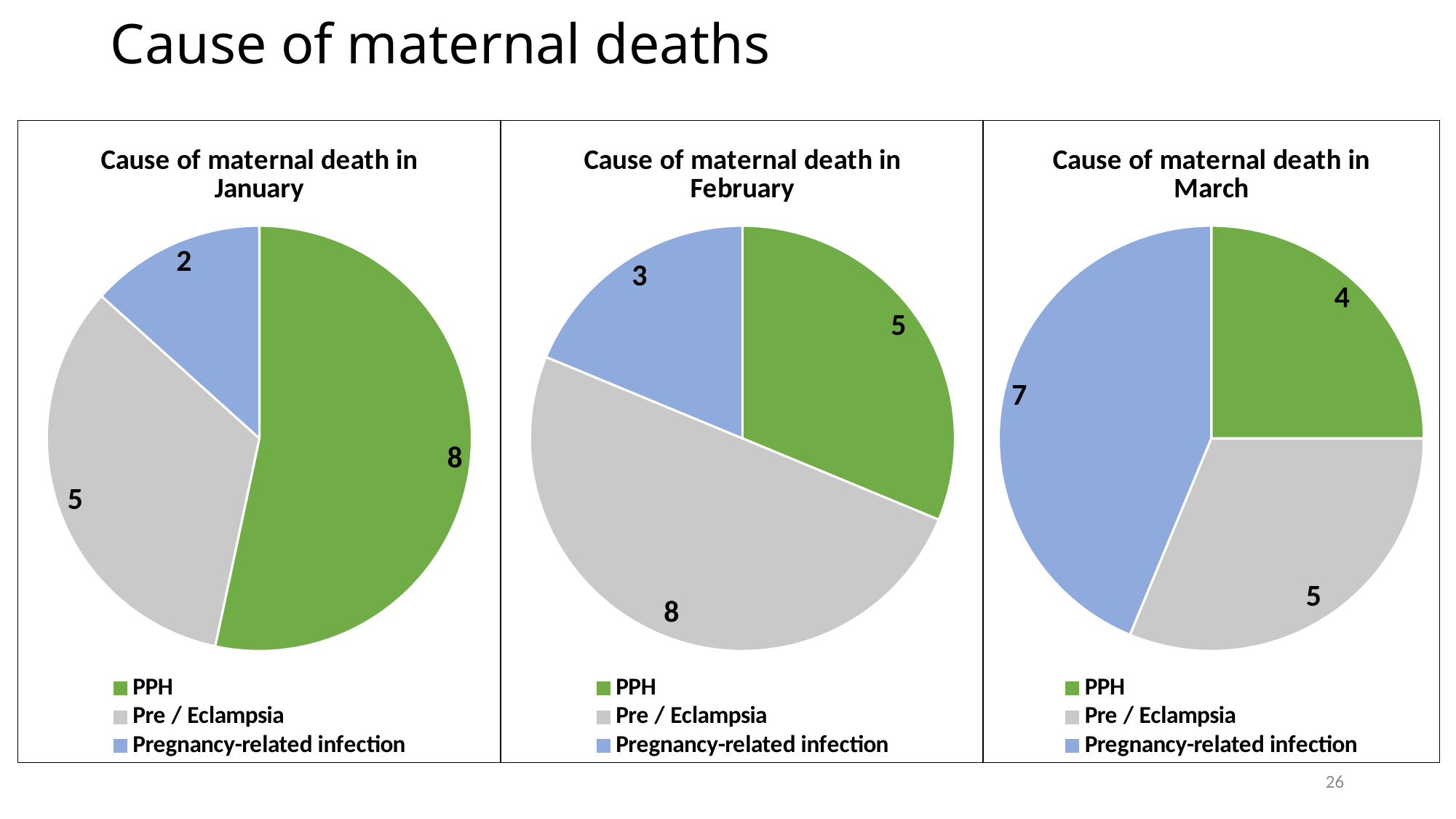
In the chart 'Cause of maternal death in February', which cause has the highest value? Pre / Eclampsia How many slices does the chart 'Cause of maternal death in January' have? 3 In the chart 'Cause of maternal death in February', what is the total of all slices? 16 In the chart 'Cause of maternal death in January', which cause has the lowest value? Pregnancy-related infection In the chart 'Cause of maternal death in March', what is the value for Pre / Eclampsia? 5 In the chart 'Cause of maternal death in January', what is the value for PPH? 8 In the chart 'Cause of maternal death in February', what share of the pie does Pre / Eclampsia represent? 50% What type of chart is 'Cause of maternal death in March'? Pie chart In the chart 'Cause of maternal death in March', which cause has the highest value? Pregnancy-related infection In the chart 'Cause of maternal death in March', which is larger, the value for PPH or the value for Pregnancy-related infection? Pregnancy-related infection In the chart 'Cause of maternal death in January', what is the difference between the PPH value and the Pre / Eclampsia value? 3 In the chart 'Cause of maternal death in February', what is the value for Pregnancy-related infection? 3